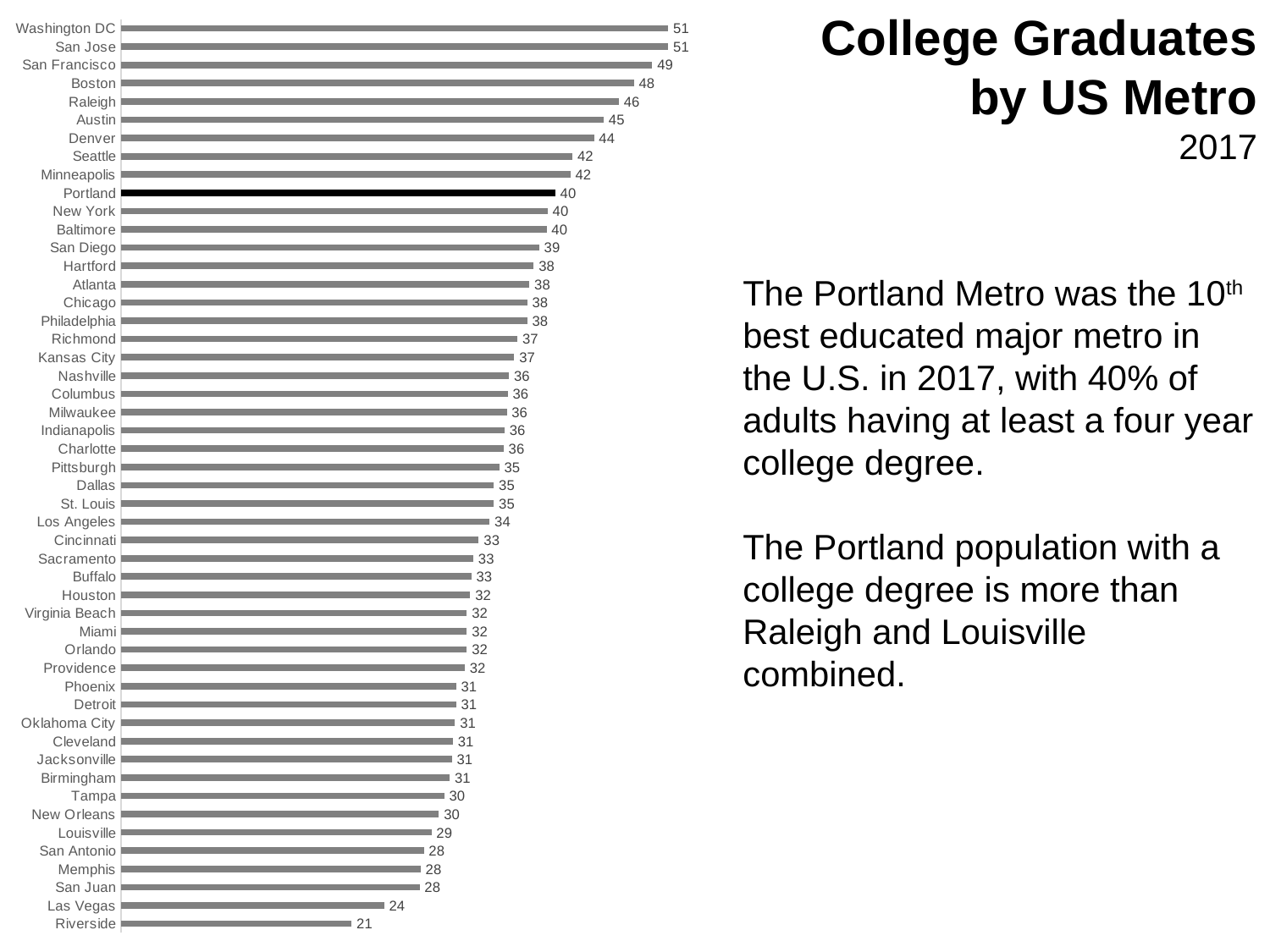
What is the difference between the values for Las Vegas and Riverside? 3 What is the difference between the values for Washington DC and Portland? 11 What is the title of the chart on the slide? College Graduates by US Metro What kind of chart is shown on the slide? Bar chart What is the value for Raleigh? 46 What is the value for Portland? 40 What is the value for Riverside? 21 How many metros are shown in the chart? 50 Which has a larger value, Boston or Denver? Boston Which has a larger value, Louisville or Tampa? Tampa Which metro has the lowest value? Riverside Which bar is highlighted in black? Portland